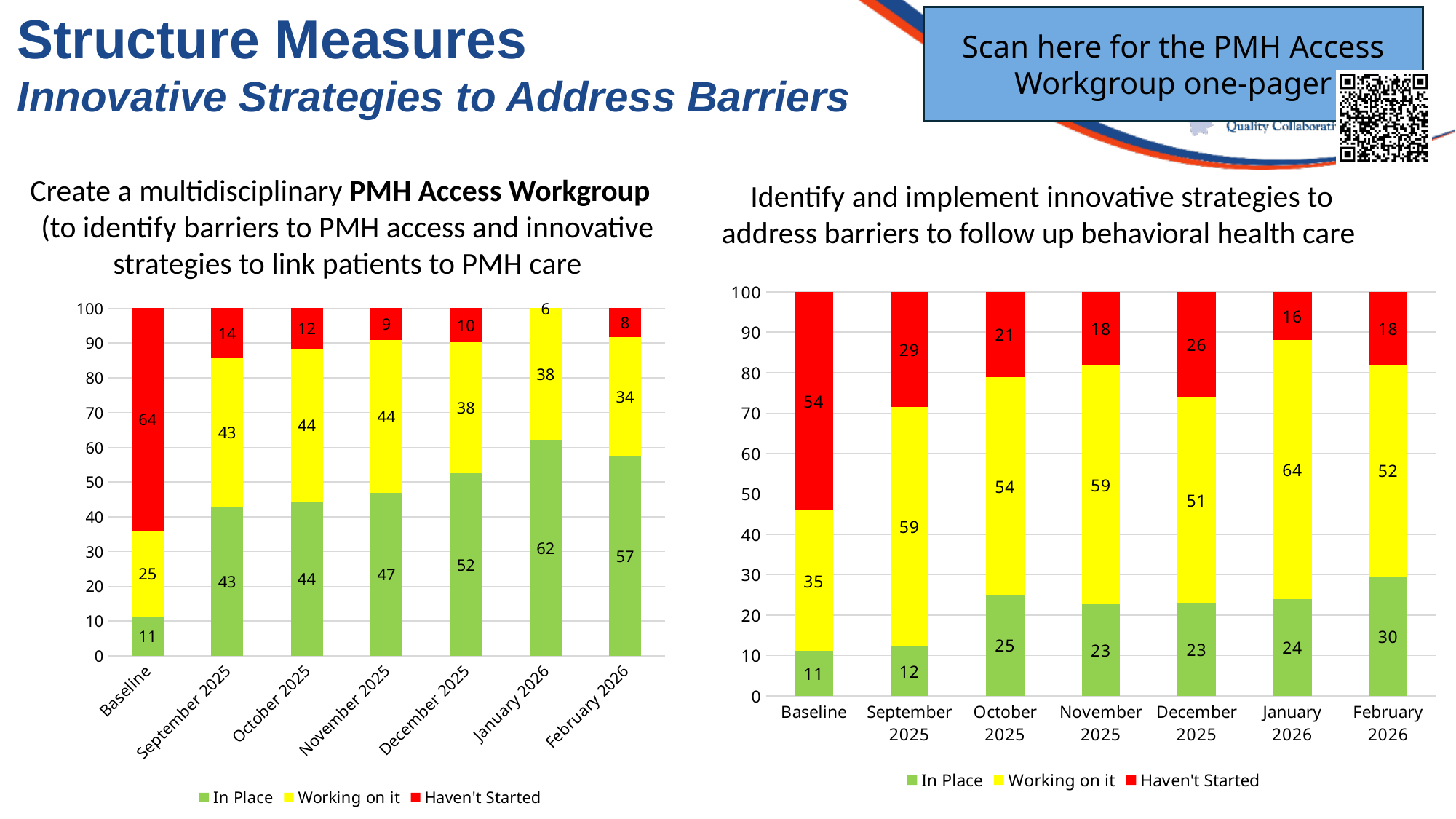
How many categories are shown on the x axis of the right chart? 7 In the left chart, what is the 'In Place' value for Baseline? 11 How many series does the legend of the left chart list? 3 In the left chart, which is larger: the 'In Place' value for December 2025 or for November 2025? December 2025 In the right chart, what is the 'Working on it' value for January 2026? 64 In the left chart, which category has the highest 'In Place' value? January 2026 In the left chart, does the 'Haven't Started' value generally rise or fall from Baseline to February 2026? Fall In the right chart, what is the 'Haven't Started' value for Baseline? 54 What kind of chart is the right chart? Stacked bar chart In the right chart, what is the difference between the 'In Place' values for February 2026 and Baseline? 19 In the right chart, which category has the lowest 'Haven't Started' value? January 2026 In the left chart, what is the 'Haven't Started' value for September 2025? 14